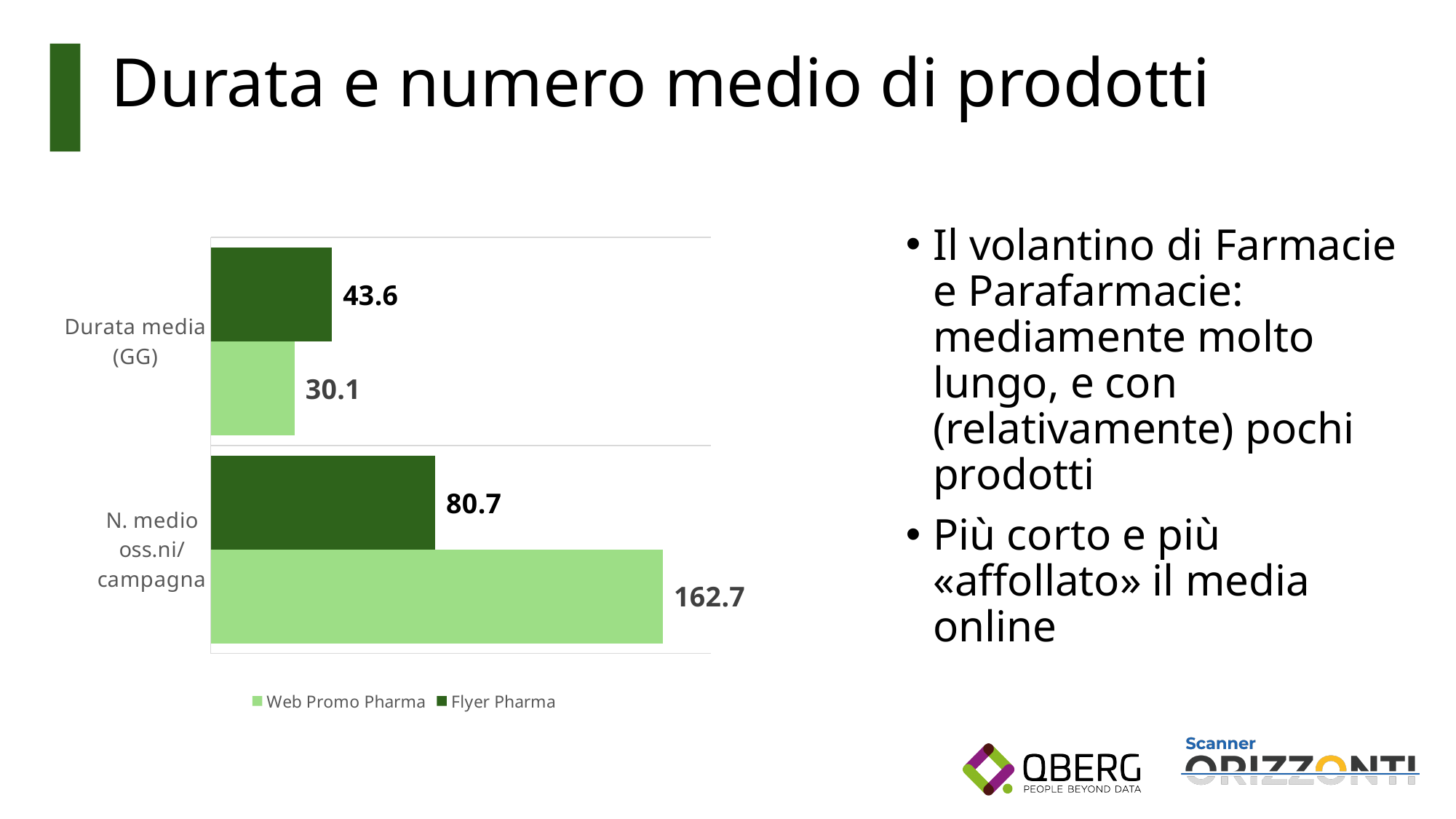
What is the value for Web Promo Pharma in the Durata media (GG) category? 30.1 What is the difference between the Flyer Pharma and Web Promo Pharma values in the Durata media (GG) category? 13.5 What is the value for Web Promo Pharma in the N. medio oss.ni/campagna category? 162.7 What is the value for Flyer Pharma in the N. medio oss.ni/campagna category? 80.7 Which series has the higher value in the N. medio oss.ni/campagna category? Web Promo Pharma What is the value for Flyer Pharma in the Durata media (GG) category? 43.6 Which bar has the highest value in the chart? Web Promo Pharma, N. medio oss.ni/campagna (162.7) How many categories are shown on the chart? 2 What is the difference between the Web Promo Pharma and Flyer Pharma values in the N. medio oss.ni/campagna category? 82 How many series does the legend list? 2 Which series has the higher value in the Durata media (GG) category? Flyer Pharma What kind of chart is shown on the slide? Bar chart